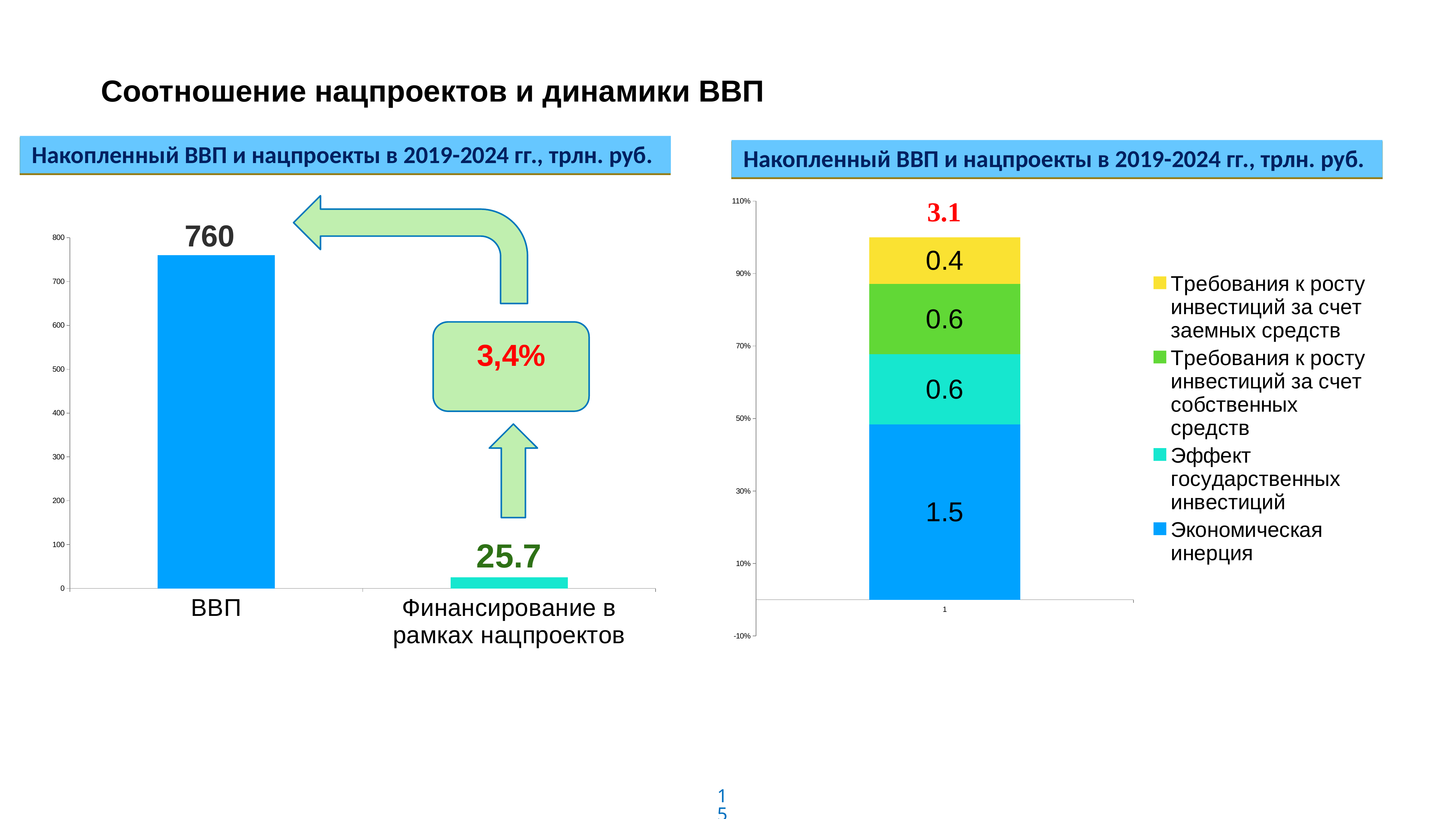
On the left chart, what is the value for ВВП? 760 On the left chart, what is the value for Финансирование в рамках нацпроектов? 25.7 What kind of chart is the left chart? bar chart On the left chart, how many categories are shown? 2 On the right chart, which series is larger: Экономическая инерция or Эффект государственных инвестиций? Экономическая инерция On the left chart, which category has the lowest value? Финансирование в рамках нацпроектов On the left chart, what is the difference between the value for ВВП and the value for Финансирование в рамках нацпроектов? 734.3 On the right chart, what is the total of the stacked bar? 3.1 On the left chart, which category has the highest value? ВВП On the right chart, how many series does the legend list? 4 On the right chart, what is the value for Требования к росту инвестиций за счет заемных средств? 0.4 On the right chart, what is the value for Экономическая инерция? 1.5